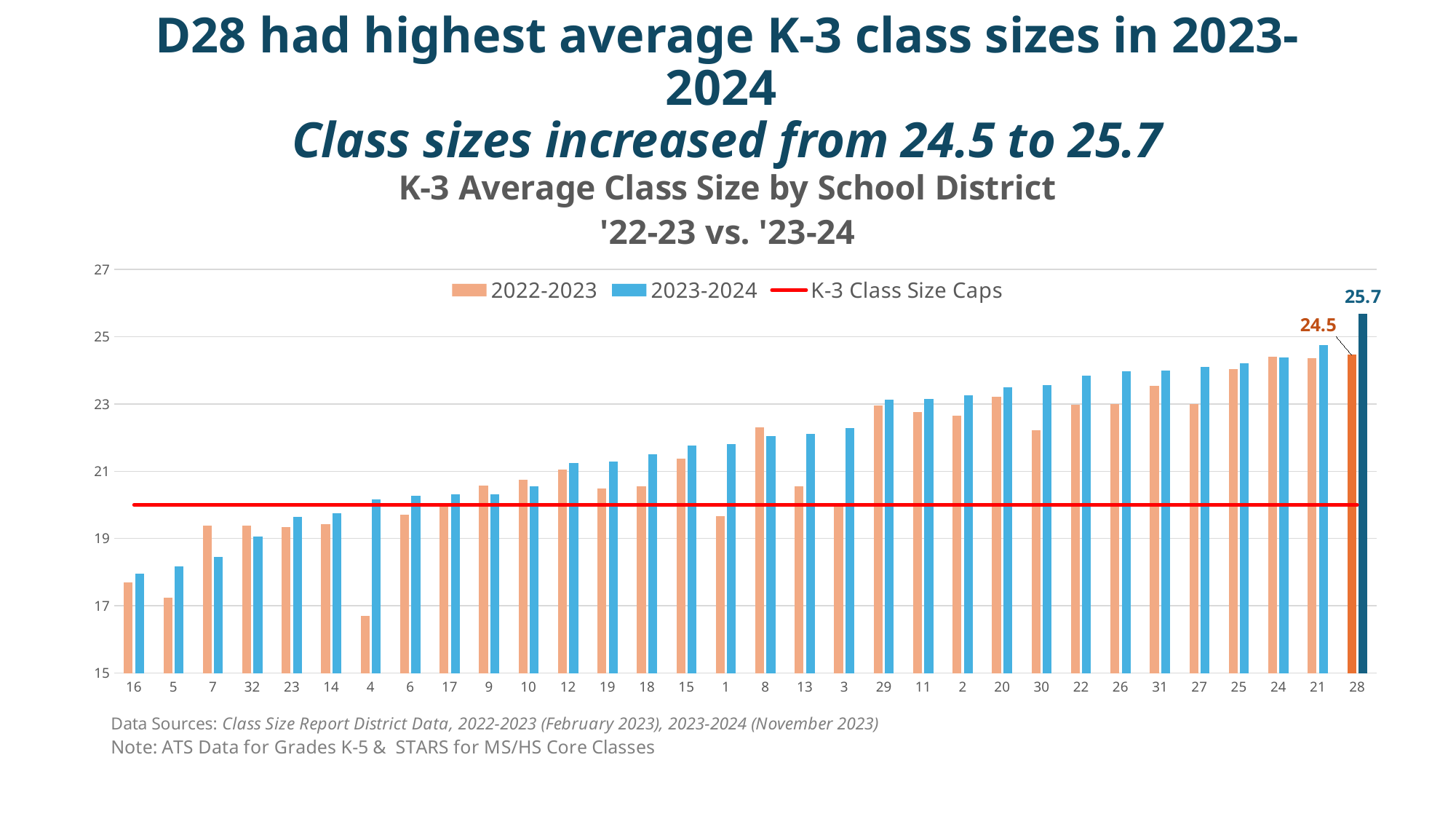
Do the 2023-2024 values generally rise or fall from left to right along the x axis? rise Which district has the highest 2023-2024 K-3 average class size? 28 Which district has the lowest 2022-2023 K-3 average class size? 4 For district 4, which is larger: the 2022-2023 value or the 2023-2024 value? 2023-2024 What is the 2023-2024 K-3 average class size for district 28? 25.7 Is the 2023-2024 value for district 16 greater or less than 19? less Is the 2022-2023 value for district 4 greater or less than 17? less How many series does the legend list? 3 What is the 2022-2023 K-3 average class size for district 28? 24.5 By how much did district 28's K-3 average class size increase from 2022-2023 to 2023-2024? 1.2 How many school districts are shown on the x axis? 31